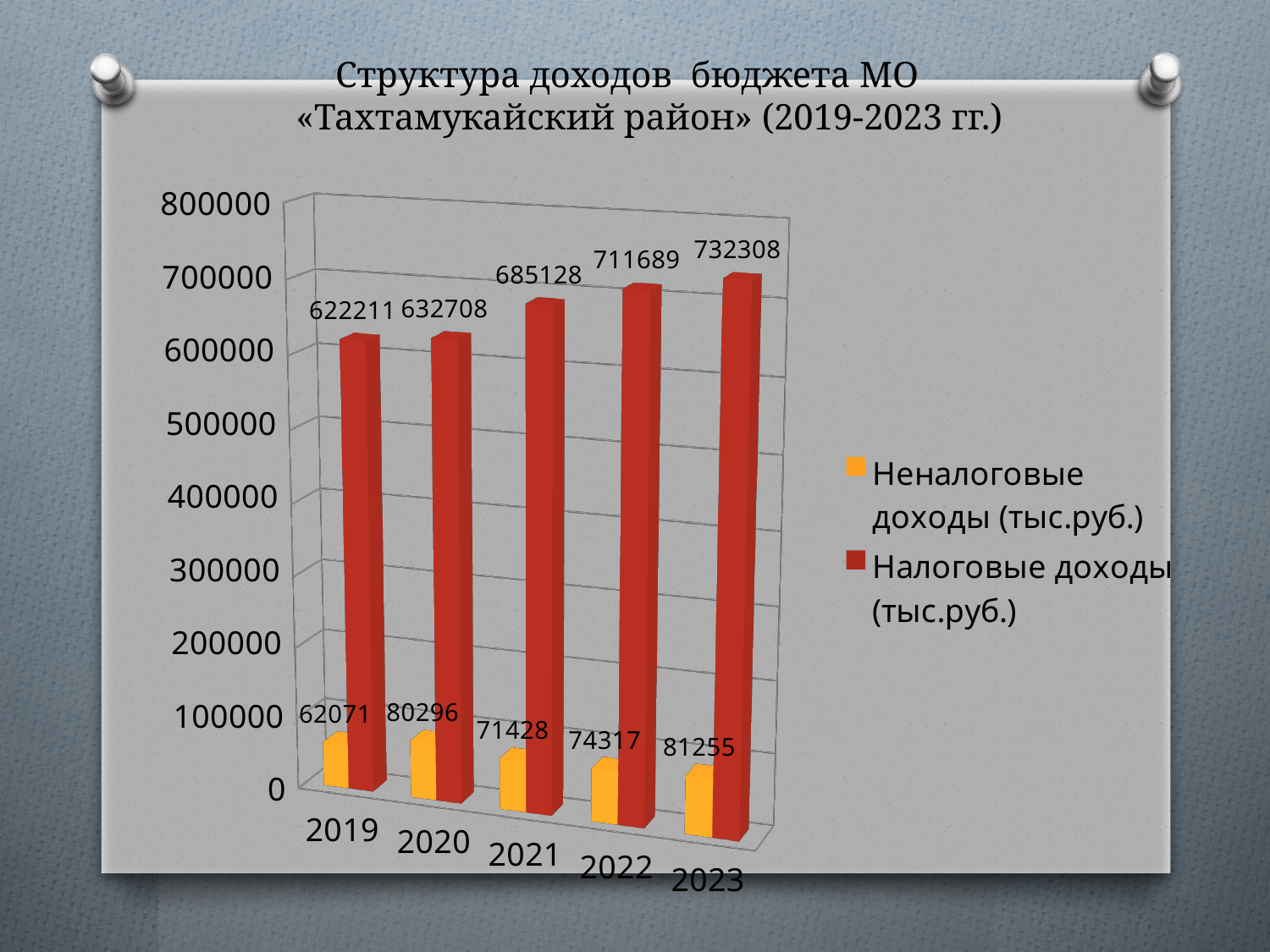
What is the difference between Неналоговые доходы in 2023 and in 2019? 19194 Is the value of Налоговые доходы for 2022 greater or less than 700000? greater What is the value of Налоговые доходы (тыс.руб.) for 2021? 685128 How many years are shown on the x axis? 5 Which year has the highest value of Налоговые доходы (тыс.руб.)? 2023 Do the values of Налоговые доходы rise or fall from 2019 to 2023? rise What is the value of Неналоговые доходы (тыс.руб.) for 2020? 80296 What is the difference between Налоговые доходы in 2023 and in 2019? 110097 Which is larger: Неналоговые доходы in 2021 or in 2022? 2022 What is the value of Налоговые доходы (тыс.руб.) for 2023? 732308 How many series does the legend list? 2 Which year has the lowest value of Неналоговые доходы (тыс.руб.)? 2019